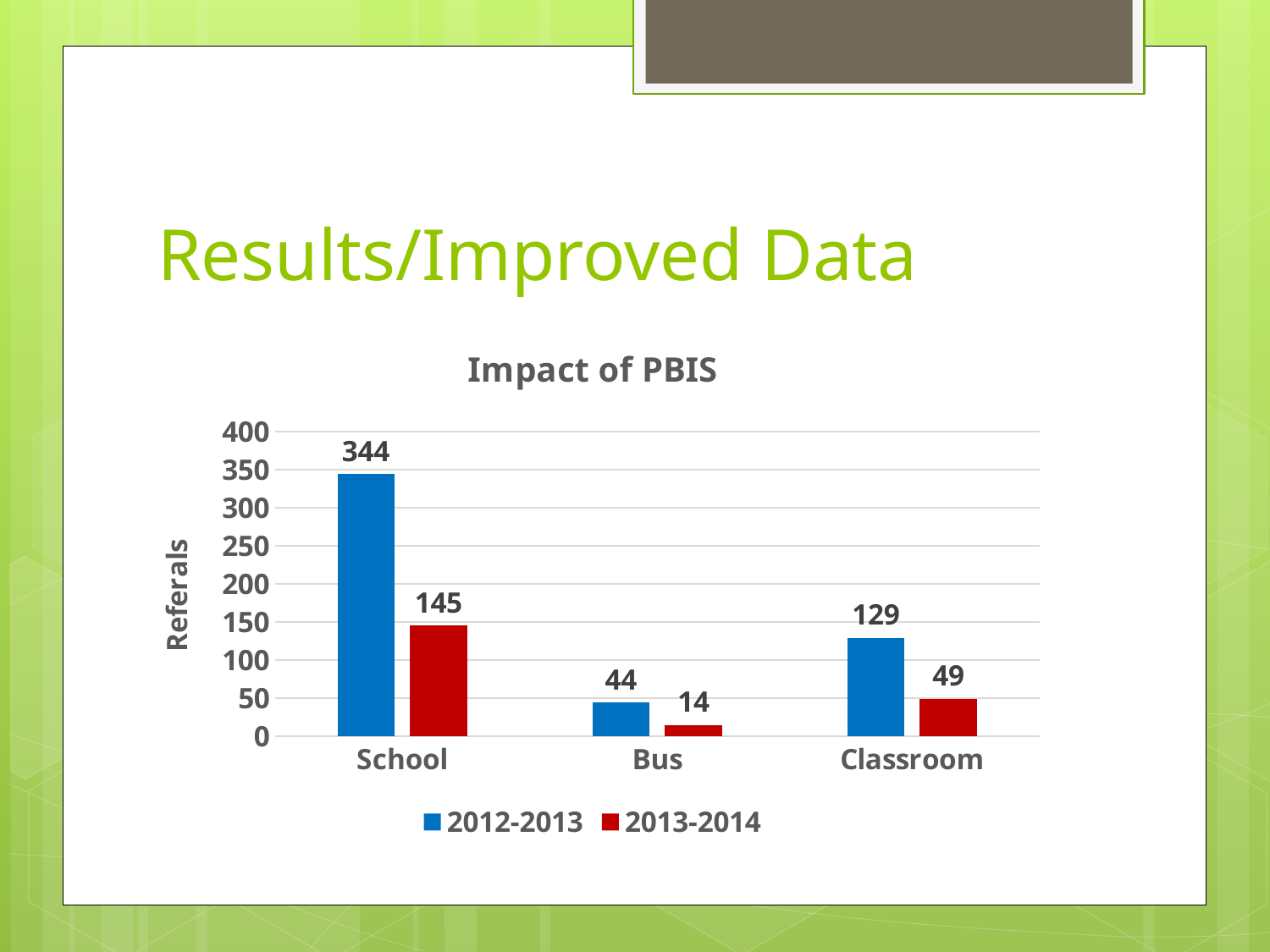
Which category has the highest number of referrals in 2012-2013? School How many series does the legend list? 2 What is the title of the chart? Impact of PBIS Which is larger: the 2013-2014 referrals for School or the 2012-2013 referrals for Classroom? 2013-2014 referrals for School What is the difference between the 2012-2013 and 2013-2014 referrals for School? 199 What is the number of referrals for Bus in 2013-2014? 14 What is the number of referrals for Classroom in 2012-2013? 129 How many categories are shown on the x axis? 3 What is the difference between the 2012-2013 and 2013-2014 referrals for Classroom? 80 What is the number of referrals for School in 2012-2013? 344 What kind of chart is shown on the slide? Bar chart Which category has the lowest number of referrals in 2013-2014? Bus